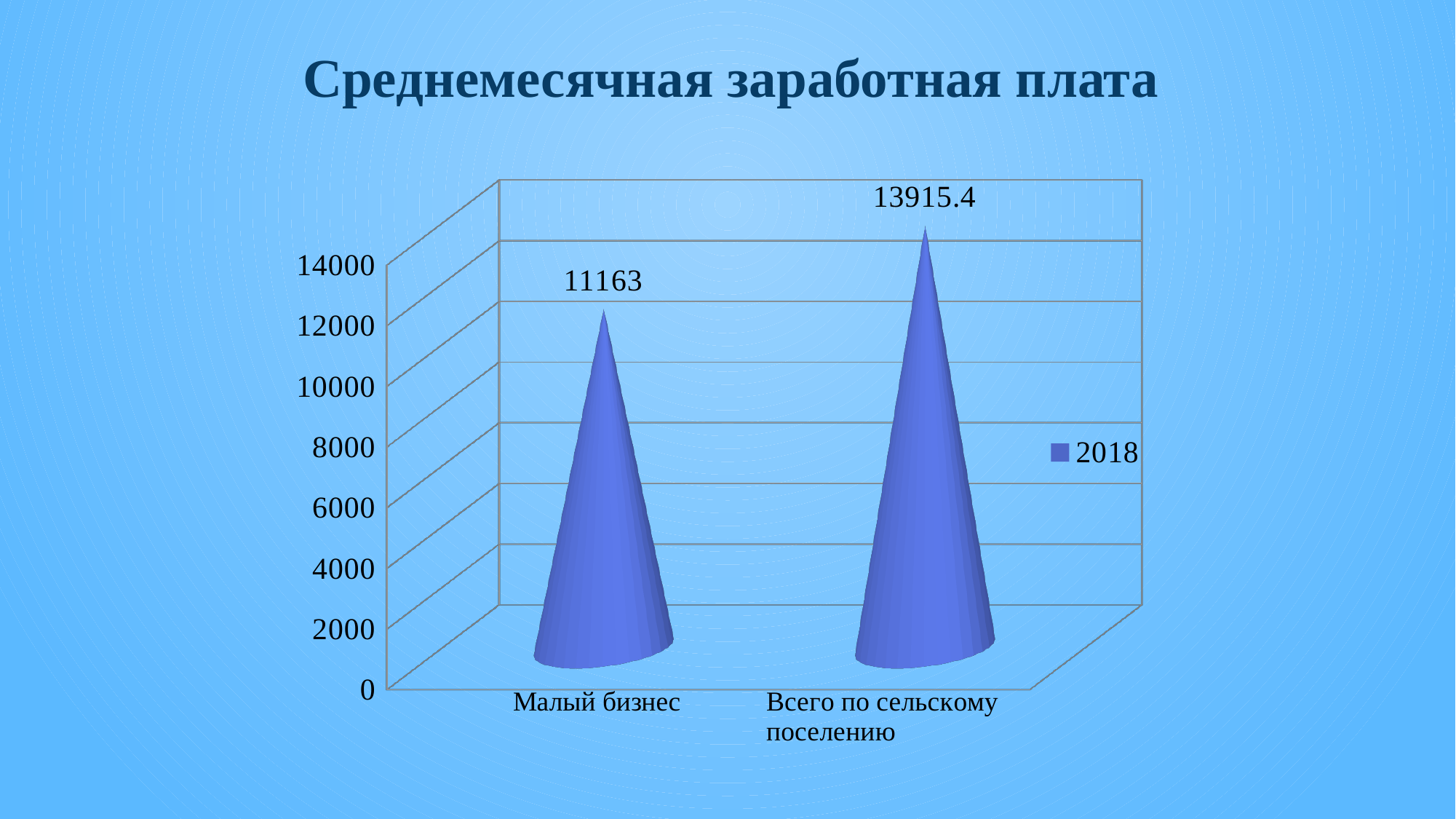
How many series does the legend list? 1 What is the title of the chart? Среднемесячная заработная плата What is the difference between the values for Всего по сельскому поселению and Малый бизнес? 2752.4 Which category has the highest value? Всего по сельскому поселению What is the value for Малый бизнес? 11163 Which is larger: the value for Малый бизнес or the value for Всего по сельскому поселению? Всего по сельскому поселению Is the value for Всего по сельскому поселению greater or less than 12000? greater Is the value for Малый бизнес greater or less than 12000? less What kind of chart is shown on the slide? bar chart Which category has the lowest value? Малый бизнес What is the value for Всего по сельскому поселению? 13915.4 How many categories are shown on the x axis? 2